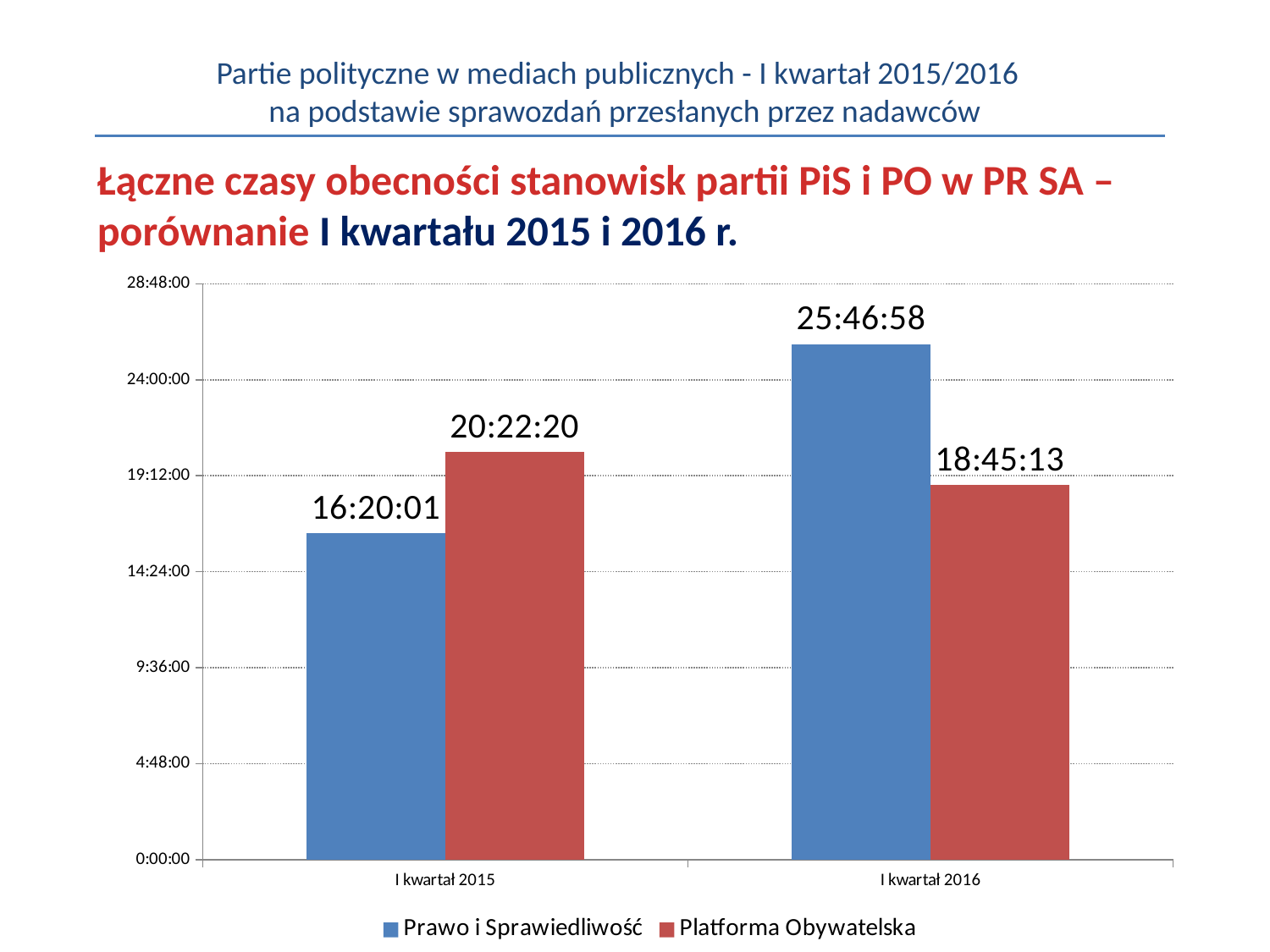
What is the value for Platforma Obywatelska in I kwartał 2015? 20:22:20 What is the value for Platforma Obywatelska in I kwartał 2016? 18:45:13 How many series does the legend list? 2 What is the difference between Prawo i Sprawiedliwość and Platforma Obywatelska in I kwartał 2016? 7:01:45 Is the value for Prawo i Sprawiedliwość in I kwartał 2016 greater or less than 24:00:00? greater What is the value for Prawo i Sprawiedliwość in I kwartał 2015? 16:20:01 Which bar has the highest value on the chart? Prawo i Sprawiedliwość, I kwartał 2016 In I kwartał 2015, which party has the larger value: Prawo i Sprawiedliwość or Platforma Obywatelska? Platforma Obywatelska Which bar has the lowest value on the chart? Prawo i Sprawiedliwość, I kwartał 2015 Does the value for Prawo i Sprawiedliwość rise or fall from I kwartał 2015 to I kwartał 2016? Rise What kind of chart is shown on the slide? Bar chart What is the value for Prawo i Sprawiedliwość in I kwartał 2016? 25:46:58